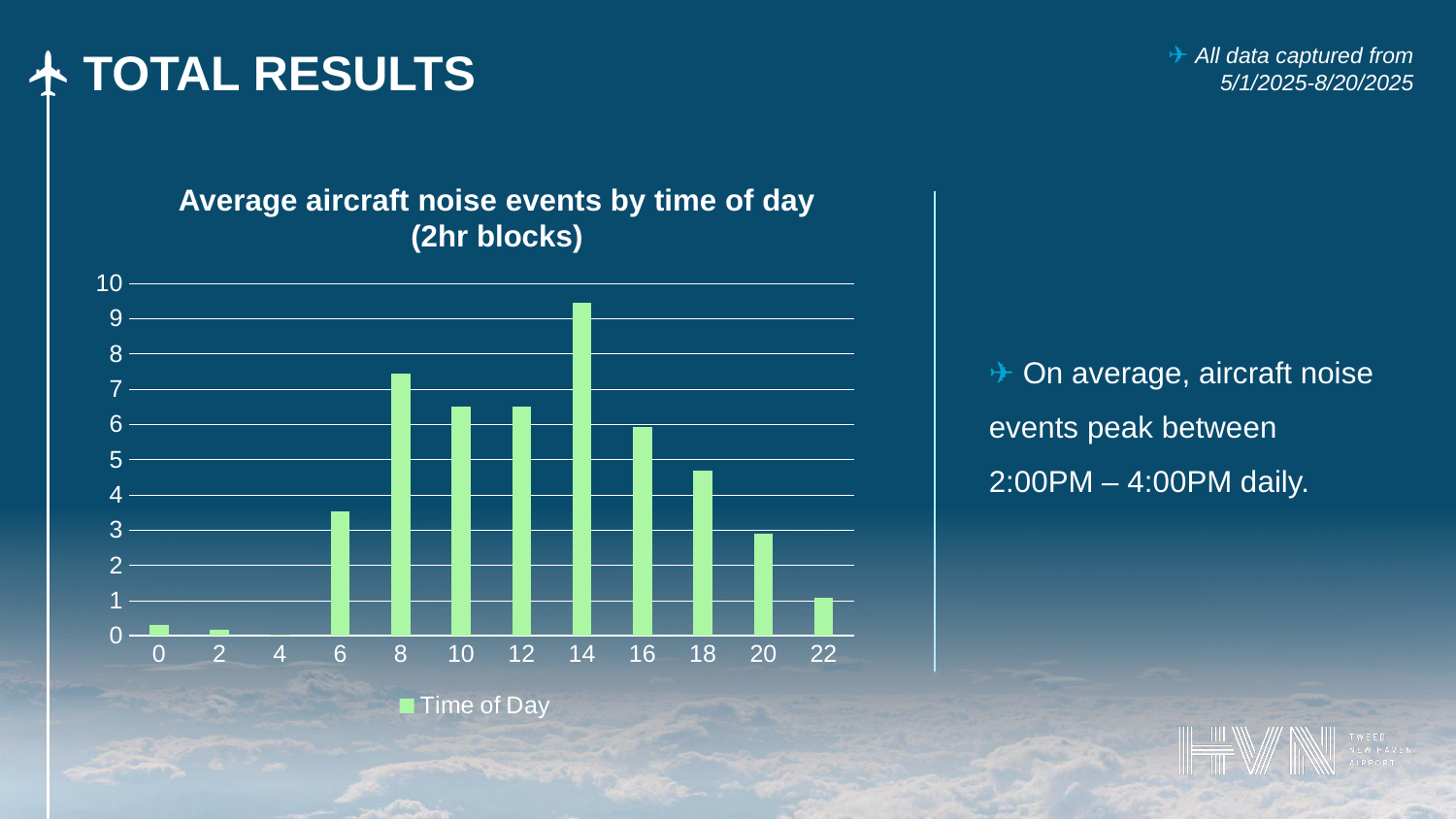
Is the value for the 18 time block greater or less than 5? less How many series does the legend list? 1 Which has a higher value, the 8 time block or the 16 time block? 8 Is the value for the 8 time block greater or less than 7? greater What kind of chart is shown on the slide? Bar chart How many time-of-day categories are plotted on the x axis? 12 What is the legend entry for the series? Time of Day Which time block has the highest average number of noise events? 14 What is the title of the chart? Average aircraft noise events by time of day (2hr blocks) Do the values rise or fall along the x axis from the 14 block to the 22 block? fall Is the value for the 14 time block greater or less than 9? greater